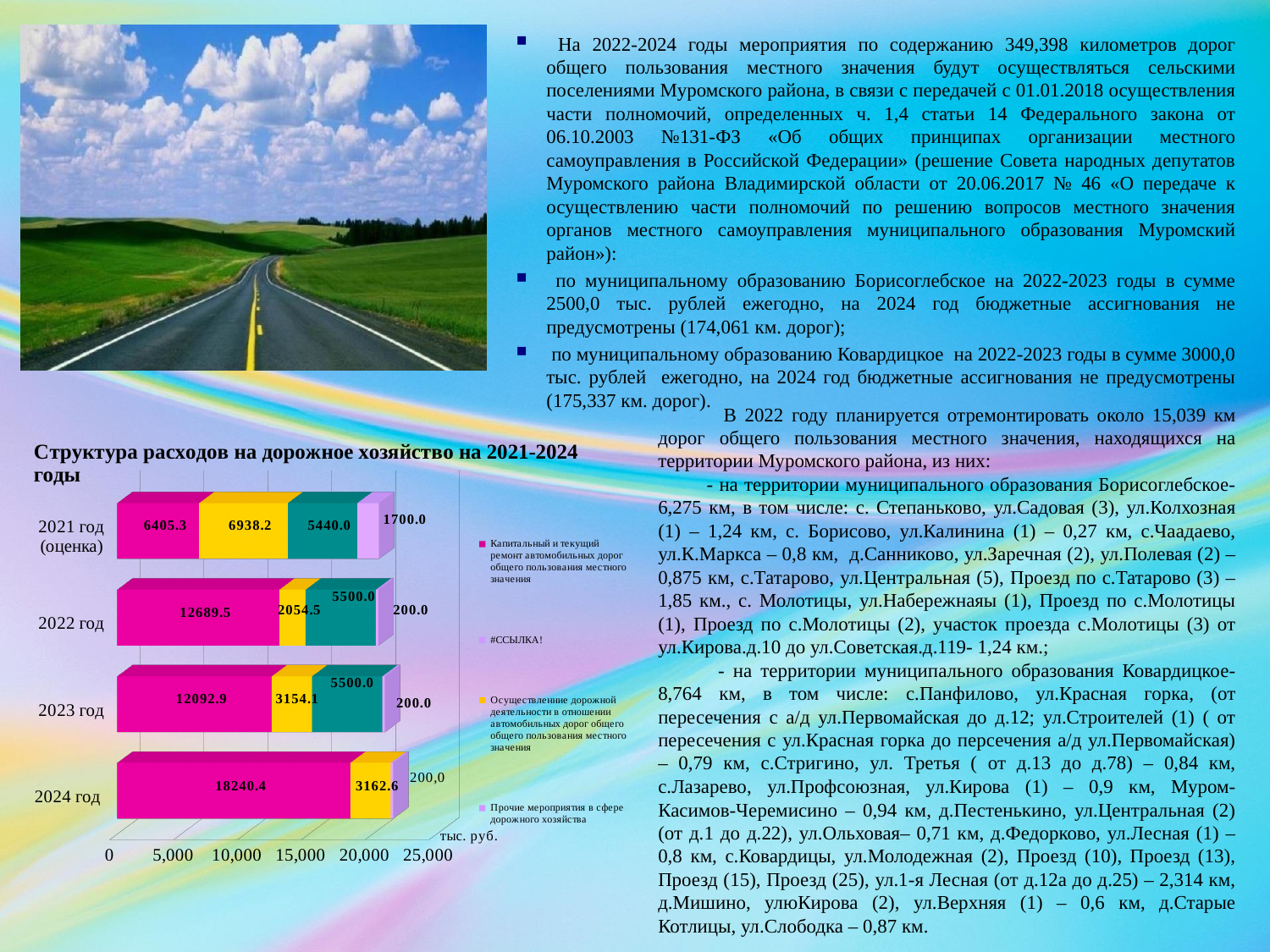
Is the magenta segment for 2022 год larger or smaller than the magenta segment for 2023 год? larger What is the title of the chart? Структура расходов на дорожное хозяйство на 2021-2024 годы What is the total of the stacked bar for 2022 год? 20444.0 Which year has the smallest magenta (leftmost) segment? 2021 год (оценка) What is the value of the magenta (leftmost) segment for 2024 год? 18240.4 What is the difference between the magenta segment values for 2024 год and 2023 год? 6147.5 What kind of chart is shown on the slide? bar chart What is the value of the magenta (leftmost) segment for 2021 год (оценка)? 6405.3 What is the value of the yellow segment for 2023 год? 3154.1 How many entries does the chart legend list? 4 How many year categories are plotted in the chart? 4 Which year has the largest magenta (leftmost) segment? 2024 год